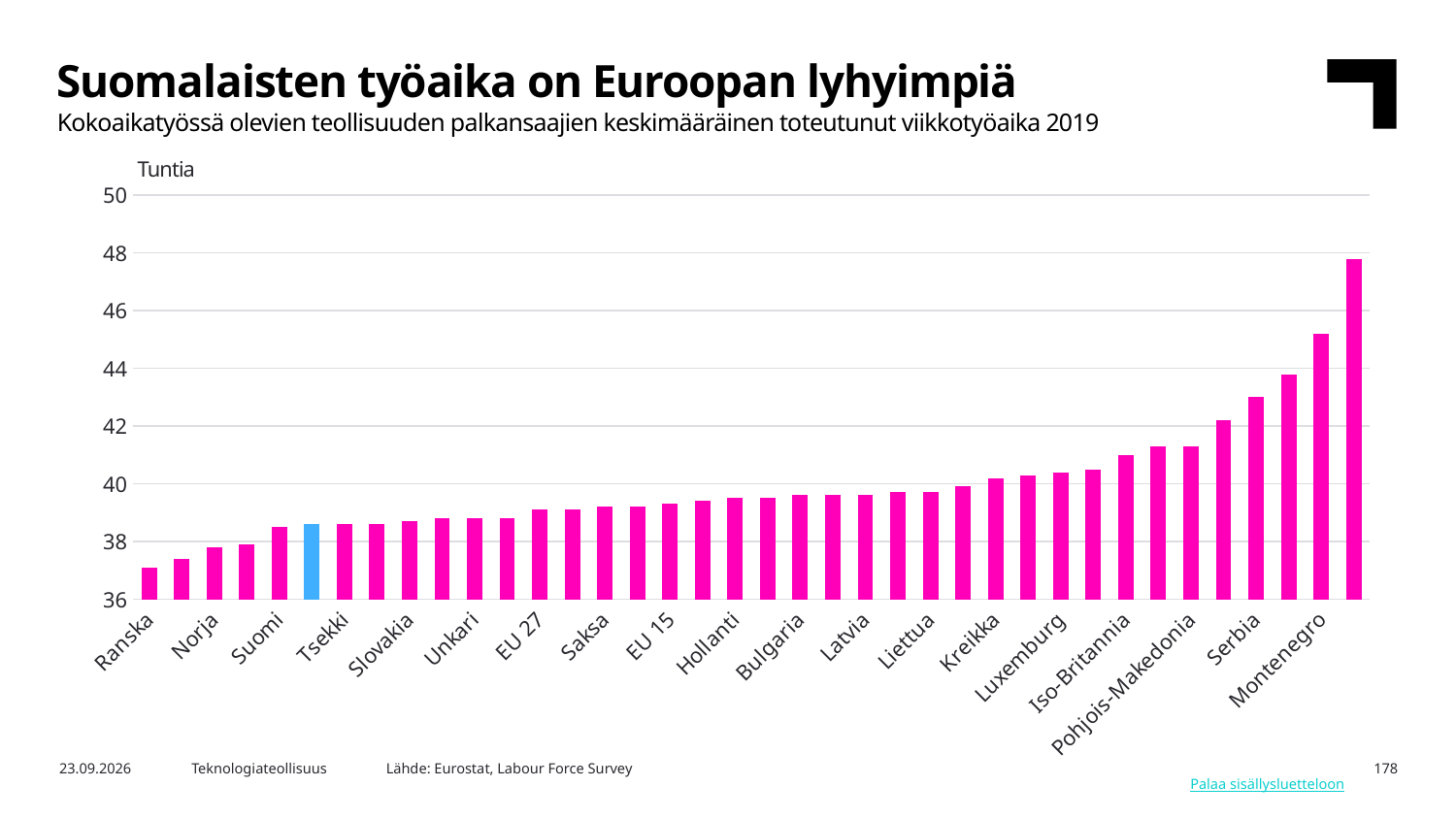
Is the value for Ranska greater or less than 38? less Which has a higher value, Serbia or Suomi? Serbia Is the value for Norja greater or less than 38? less Is the value for Saksa greater or less than 40? less Which country has the lowest average weekly working time in the chart? Ranska Do the values rise or fall from left to right along the x axis? rise Which has a higher value, Montenegro or Ranska? Montenegro What unit is shown on the vertical axis of the chart? Tuntia What kind of chart is shown on the slide? bar chart